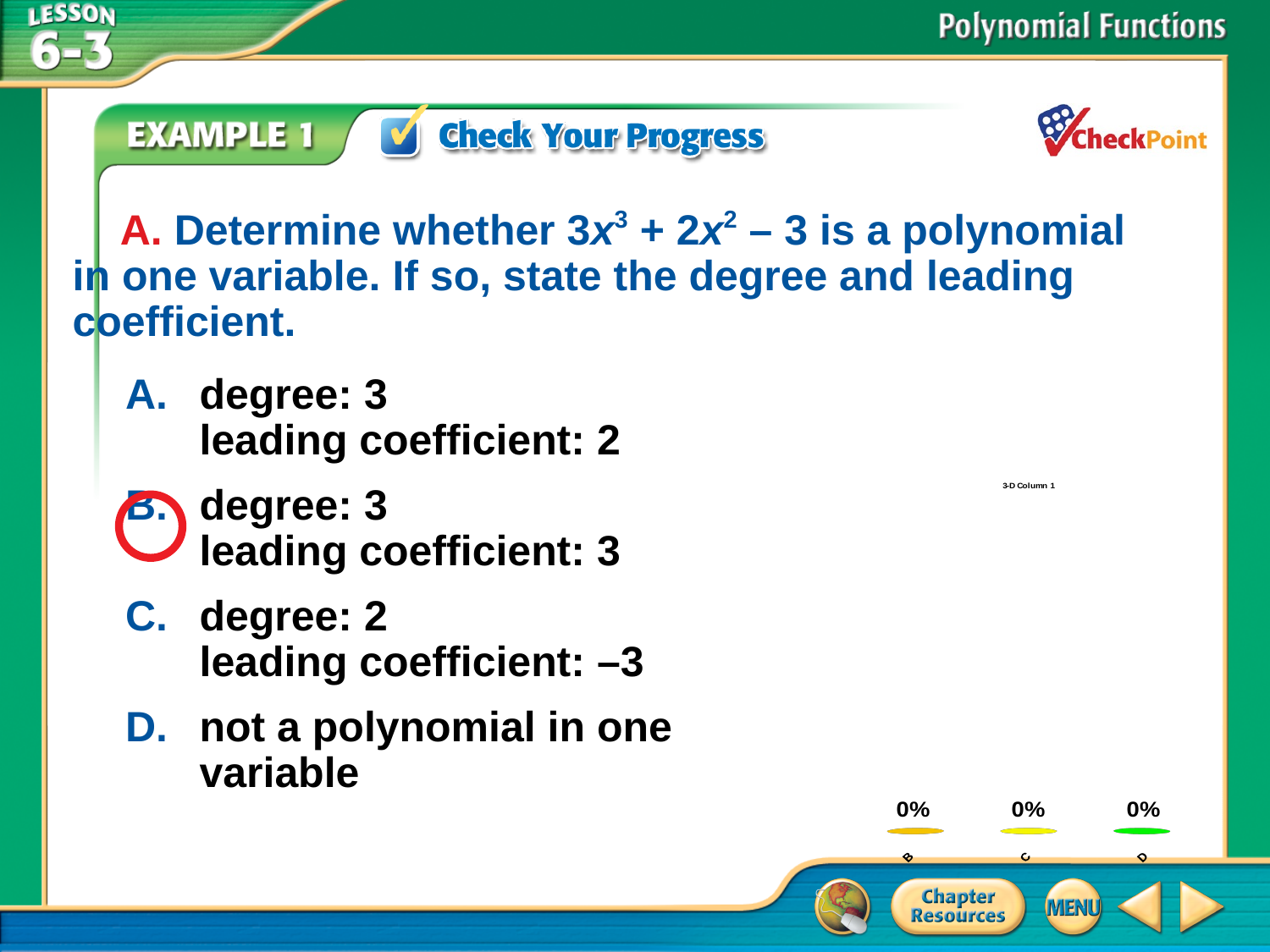
In the chart in the lower right of the slide, what is the value shown for category C? 0% In the chart in the lower right of the slide, what is the value shown for category D? 0% In the chart in the lower right of the slide, what is the value shown for category B? 0% What kind of chart is shown in the lower right of the slide? bar chart In the chart in the lower right of the slide, is the value for category D greater or less than 50%? less